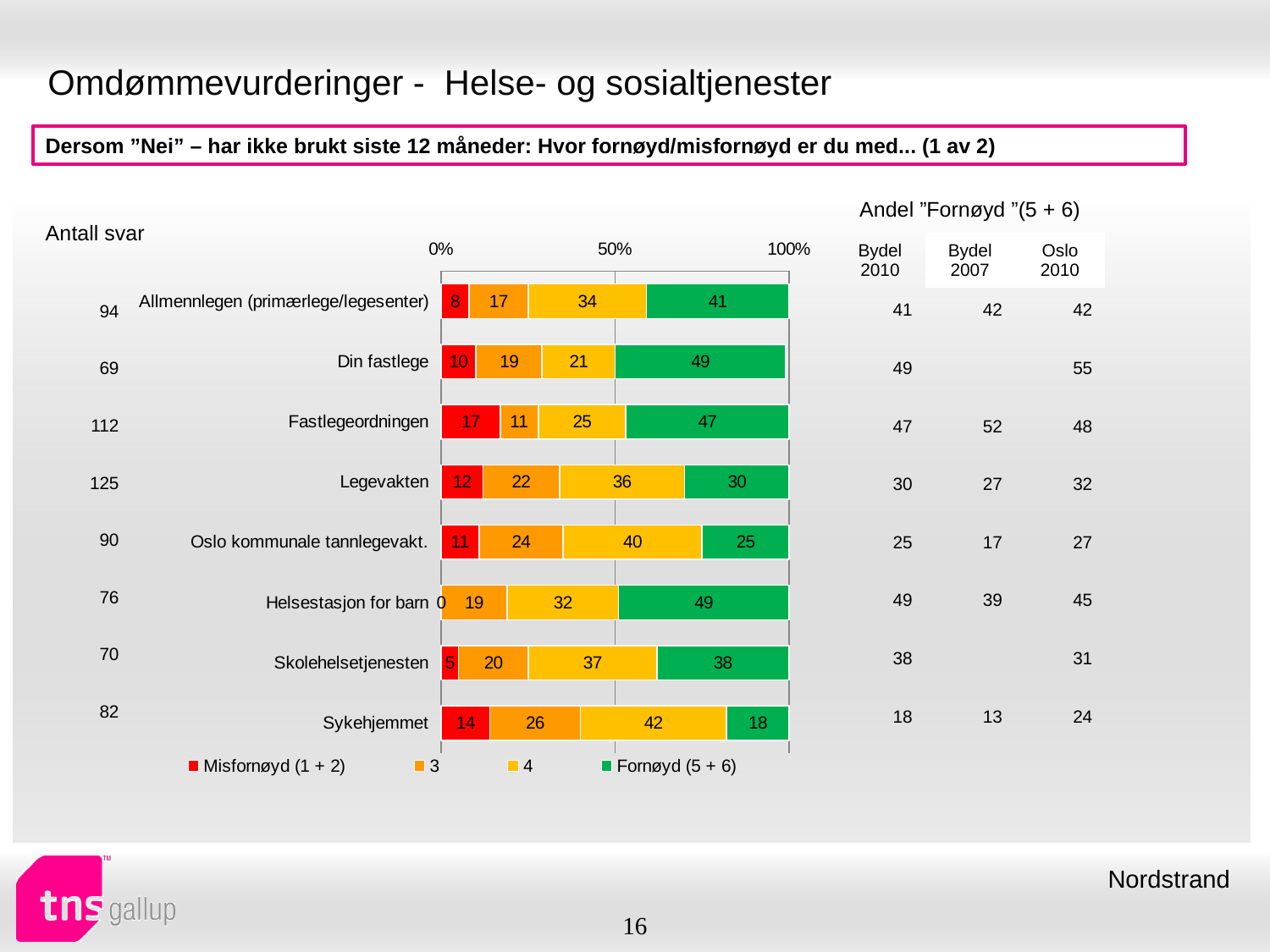
Which is larger for Legevakten: the '3' value or the 'Fornøyd (5 + 6)' value? Fornøyd (5 + 6) Which colour represents 'Fornøyd (5 + 6)' in the chart? green Which category has the highest 'Misfornøyd (1 + 2)' value? Fastlegeordningen Which category has the lowest 'Fornøyd (5 + 6)' value? Sykehjemmet What kind of chart is shown on the slide? stacked bar chart What is the difference between the '4' value and the 'Fornøyd (5 + 6)' value for Sykehjemmet? 24 What is the value of series '4' for Oslo kommunale tannlegevakt.? 40 What is the 'Misfornøyd (1 + 2)' value for Fastlegeordningen? 17 What is the 'Fornøyd (5 + 6)' value for Sykehjemmet? 18 How many categories (services) are plotted in the chart? 8 What is the total of the stacked bar for Din fastlege? 99 How many series does the legend list? 4